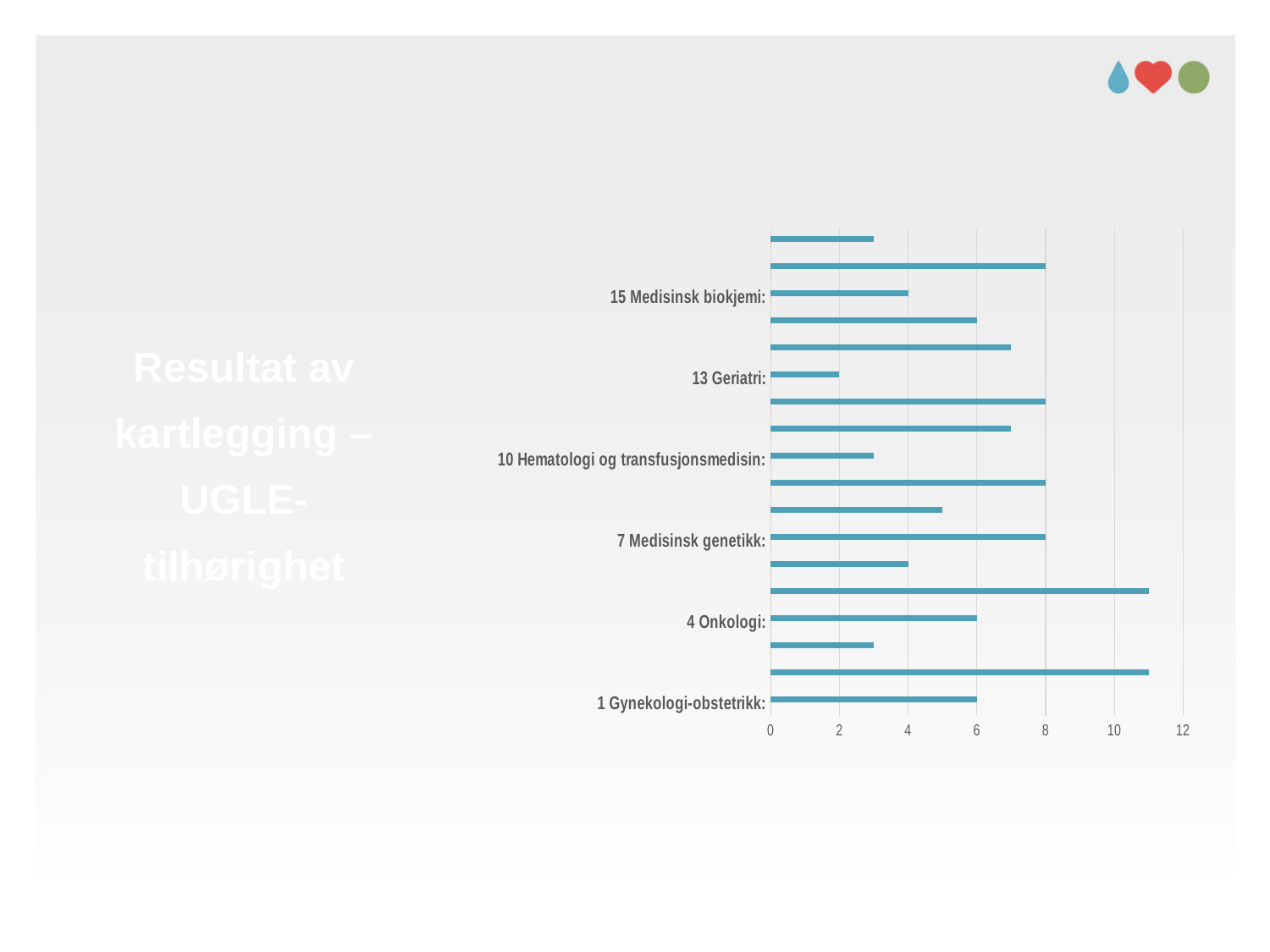
Which has the larger value, 7 Medisinsk genetikk or 13 Geriatri? 7 Medisinsk genetikk What is the value for 13 Geriatri? 2 What is the value for 15 Medisinsk biokjemi? 4 What is the difference between the values for 7 Medisinsk genetikk and 13 Geriatri? 6 What kind of chart is shown on the slide? bar chart Of the labelled categories, which has the lowest value? 13 Geriatri What is the value for 7 Medisinsk genetikk? 8 What is the highest value shown on the horizontal axis? 12 Is the value for 10 Hematologi og transfusjonsmedisin greater or less than 4? less How many category labels are shown on the vertical axis? 6 What is the value for 4 Onkologi? 6 What is the value for 1 Gynekologi-obstetrikk? 6